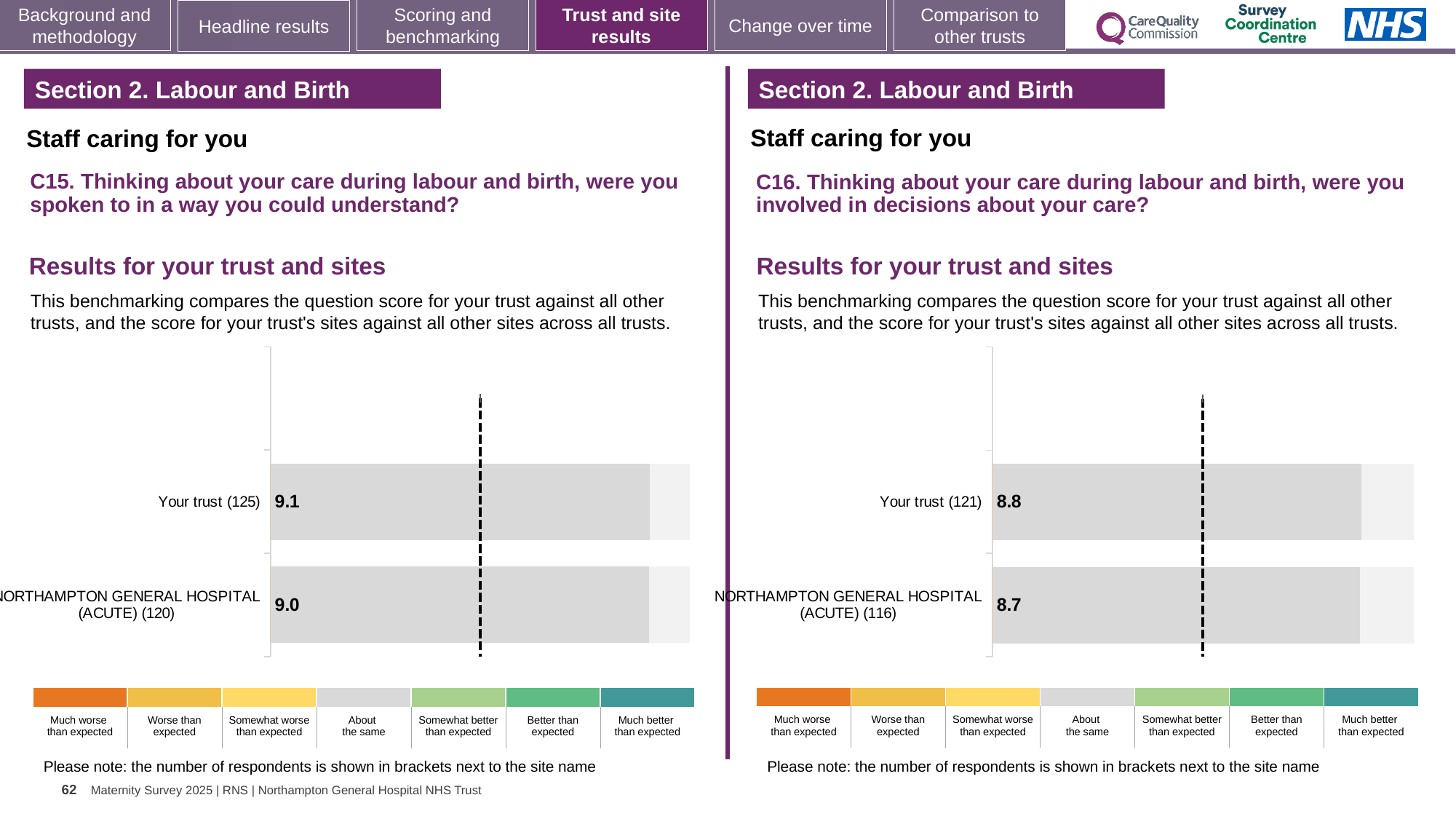
In the C16 chart on the right, what is the score for NORTHAMPTON GENERAL HOSPITAL (ACUTE) (116)? 8.7 What type of chart is used in the C16 chart on the right? Bar chart In the C16 chart on the right, what is the difference between the Your trust score and the NORTHAMPTON GENERAL HOSPITAL (ACUTE) score? 0.1 In the C16 chart on the right, which has the lower score: Your trust or NORTHAMPTON GENERAL HOSPITAL (ACUTE)? NORTHAMPTON GENERAL HOSPITAL (ACUTE) How many respondents are shown in brackets for Your trust in the C16 chart on the right? 121 How many bars are plotted in the C15 chart on the left? 2 In the C16 chart on the right, what is the score for Your trust (121)? 8.8 In the C15 chart on the left, what is the score for Your trust (125)? 9.1 In the C15 chart on the left, which has the higher score: Your trust or NORTHAMPTON GENERAL HOSPITAL (ACUTE)? Your trust In the C15 chart on the left, what is the score for NORTHAMPTON GENERAL HOSPITAL (ACUTE) (120)? 9.0 In the C15 chart on the left, what is the difference between the Your trust score and the NORTHAMPTON GENERAL HOSPITAL (ACUTE) score? 0.1 How many categories does the colour key below the C15 chart on the left list? 7